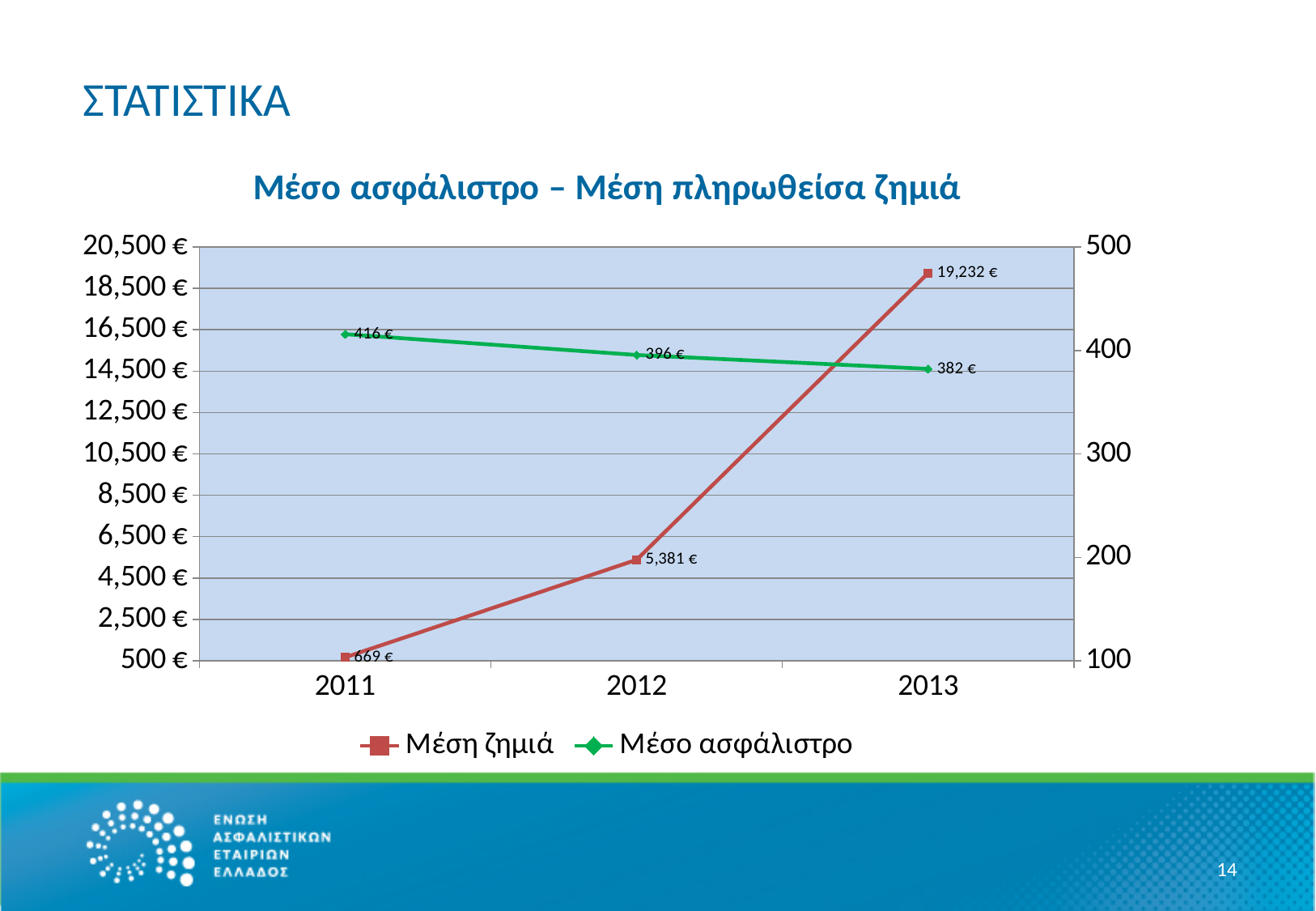
In which year is Μέση ζημιά the lowest? 2011 What is the value of Μέσο ασφάλιστρο in 2013? 382 € What is the difference between the Μέση ζημιά values for 2013 and 2012? 13,851 € What type of chart is shown on the slide? Line chart In which year is Μέσο ασφάλιστρο the highest? 2011 What is the value of Μέσο ασφάλιστρο in 2011? 416 € How does Μέσο ασφάλιστρο change from 2011 to 2013? It falls What is the value of Μέση ζημιά in 2012? 5,381 € What is the value of Μέση ζημιά in 2013? 19,232 € How many series does the legend list? 2 What is the difference between the Μέσο ασφάλιστρο values for 2011 and 2012? 20 € Which is larger: Μέσο ασφάλιστρο in 2012 or in 2013? 2012